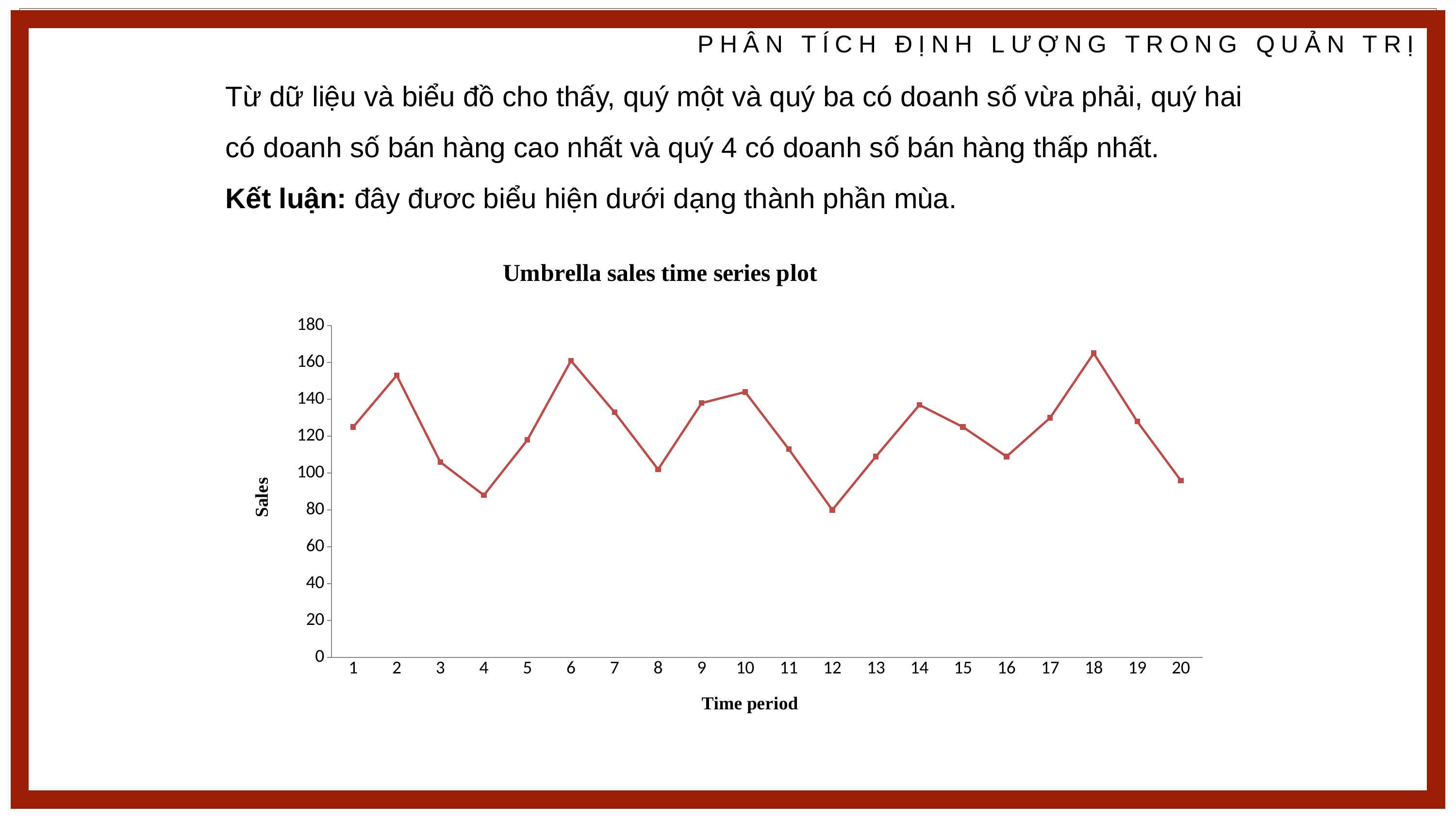
What is the title of the chart? Umbrella sales time series plot Which has the higher sales value, time period 12 or time period 14? time period 14 What kind of chart is shown on the slide? line chart Which time period has the lowest sales value? 12 Do sales rise or fall from time period 2 to time period 4? fall Which has the higher sales value, time period 2 or time period 4? time period 2 Is the sales value for time period 4 greater or less than 100? less Is the sales value for time period 2 greater or less than 140? greater How many time periods are plotted on the chart? 20 What is the label of the vertical axis of the chart? Sales Is the sales value for time period 12 greater or less than 100? less